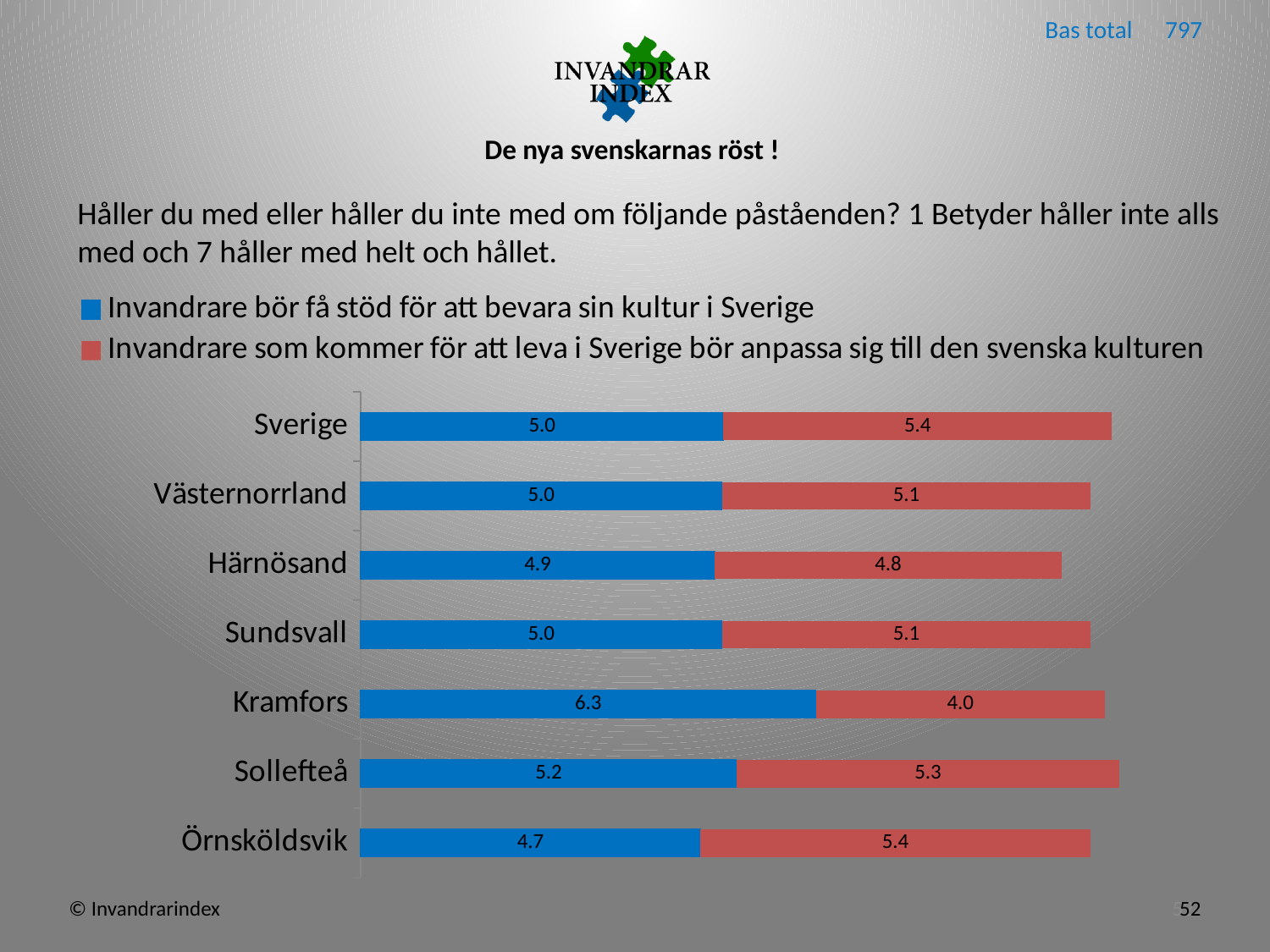
For Sverige, which series has the larger value: 'Invandrare bör få stöd för att bevara sin kultur i Sverige' or 'Invandrare som kommer för att leva i Sverige bör anpassa sig till den svenska kulturen'? Invandrare som kommer för att leva i Sverige bör anpassa sig till den svenska kulturen Which region has the lowest value in the series 'Invandrare som kommer för att leva i Sverige bör anpassa sig till den svenska kulturen'? Kramfors How many categories (regions) are shown on the chart? 7 What kind of chart is shown on the slide? stacked bar chart What is the total of the stacked bar for Sollefteå? 10.5 Which region has the highest value in the series 'Invandrare bör få stöd för att bevara sin kultur i Sverige'? Kramfors What is the value for Härnösand in the series 'Invandrare som kommer för att leva i Sverige bör anpassa sig till den svenska kulturen'? 4.8 How many series does the legend list? 2 What is the value for Örnsköldsvik in the series 'Invandrare som kommer för att leva i Sverige bör anpassa sig till den svenska kulturen'? 5.4 For Kramfors, what is the difference between the value for 'Invandrare bör få stöd för att bevara sin kultur i Sverige' and the value for 'Invandrare som kommer för att leva i Sverige bör anpassa sig till den svenska kulturen'? 2.3 Which region has the lowest value in the series 'Invandrare bör få stöd för att bevara sin kultur i Sverige'? Örnsköldsvik What is the value for Kramfors in the series 'Invandrare bör få stöd för att bevara sin kultur i Sverige'? 6.3